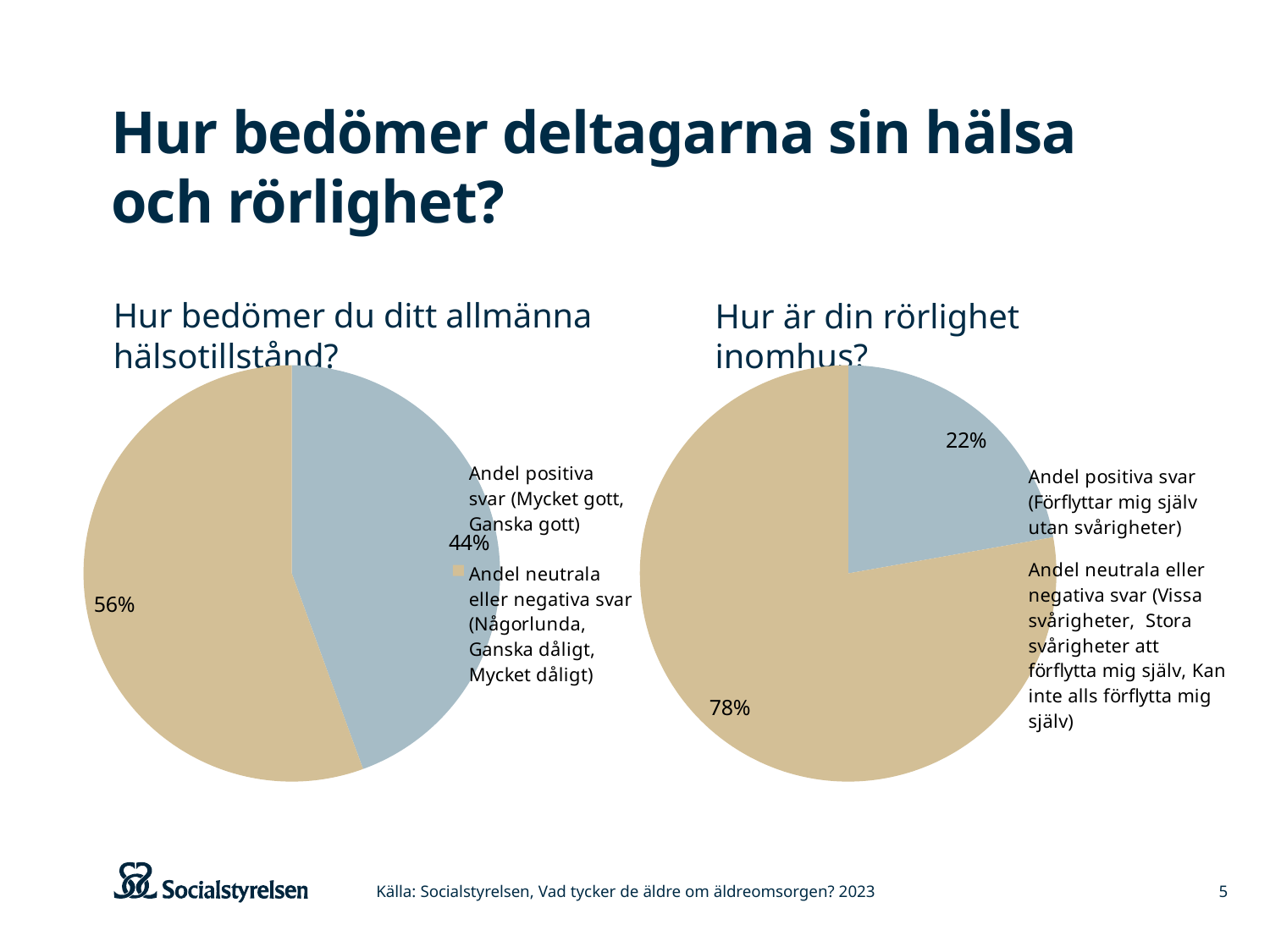
In the left chart 'Hur bedömer du ditt allmänna hälsotillstånd?', which slice is the smallest? Andel positiva svar In the right chart 'Hur är din rörlighet inomhus?', what is the difference in percentage points between the neutral/negative share and the positive share? 56 percentage points In the left chart 'Hur bedömer du ditt allmänna hälsotillstånd?', what share is labelled for the neutral or negative answers (Andel neutrala eller negativa svar)? 56% How many slices does the left chart 'Hur bedömer du ditt allmänna hälsotillstånd?' have? 2 In the right chart 'Hur är din rörlighet inomhus?', what colour is the slice for 'Andel positiva svar'? Blue-grey Which chart shows a larger share of positive answers: the left chart on general health or the right chart on indoor mobility? The left chart (Hur bedömer du ditt allmänna hälsotillstånd?) In the right chart 'Hur är din rörlighet inomhus?', what share is labelled for the positive answers (Andel positiva svar)? 22% What type of chart is used for 'Hur är din rörlighet inomhus?'? Pie chart In the right chart 'Hur är din rörlighet inomhus?', what share is labelled for the neutral or negative answers? 78% In the left chart 'Hur bedömer du ditt allmänna hälsotillstånd?', what is the difference in percentage points between the neutral/negative share and the positive share? 12 percentage points In the right chart 'Hur är din rörlighet inomhus?', which slice is the largest? Andel neutrala eller negativa svar In the left chart 'Hur bedömer du ditt allmänna hälsotillstånd?', what share is labelled for the positive answers (Andel positiva svar)? 44%